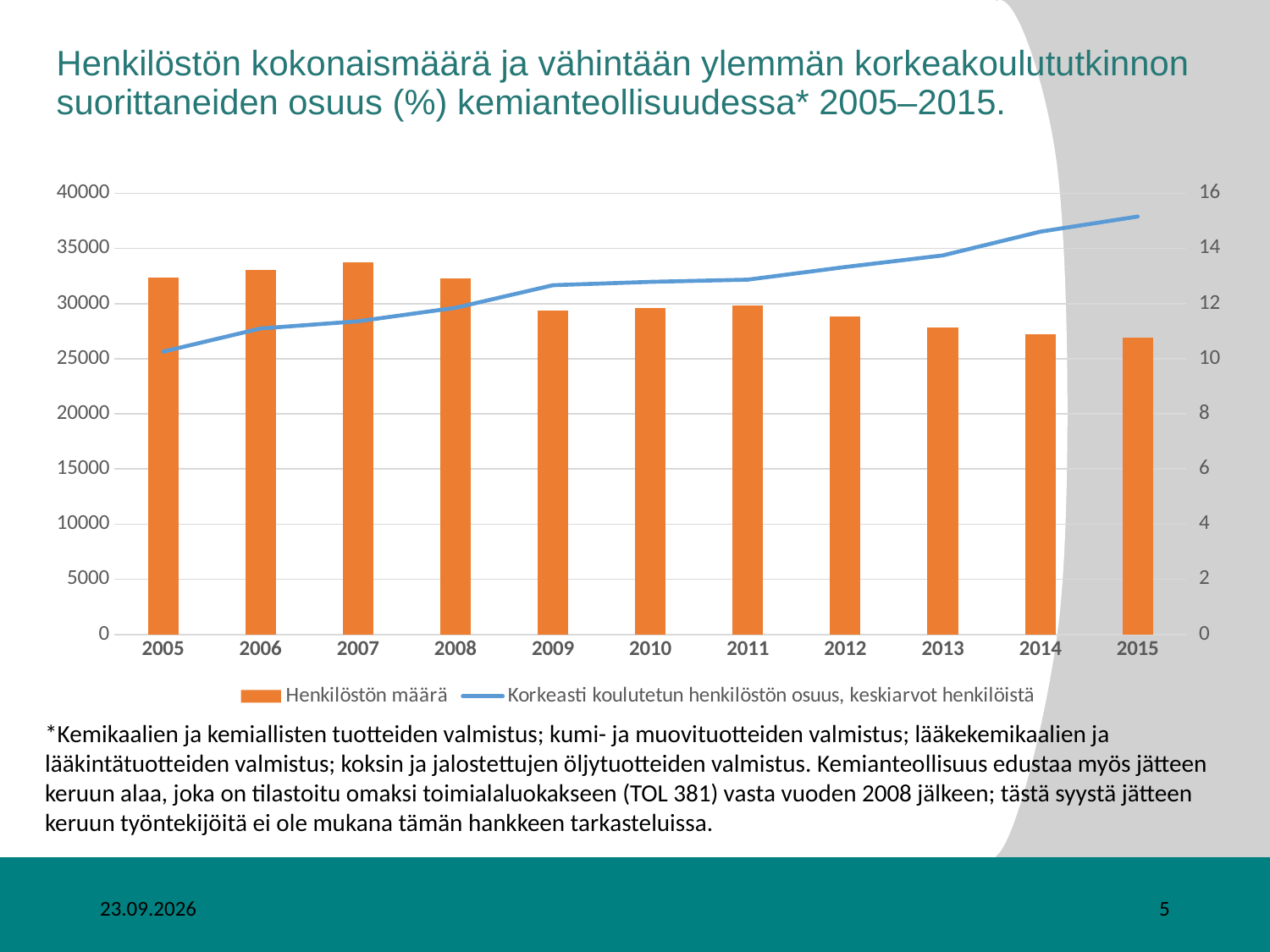
Is the Henkilöstön määrä bar for 2015 greater or less than 30000? less What colour are the bars for Henkilöstön määrä? Orange Is the value of the Korkeasti koulutetun henkilöstön osuus line for 2015 greater or less than 14 on the right axis? greater Does the line for Korkeasti koulutetun henkilöstön osuus rise or fall from 2005 to 2015? It rises Which is larger, the Henkilöstön määrä bar for 2007 or for 2013? 2007 Is the Henkilöstön määrä bar for 2013 greater or less than 30000? less How many years are shown on the x axis of the chart? 11 What kind of chart is shown on the slide? A combined bar and line chart How many series does the chart legend list? 2 Which year has the highest bar for Henkilöstön määrä? 2007